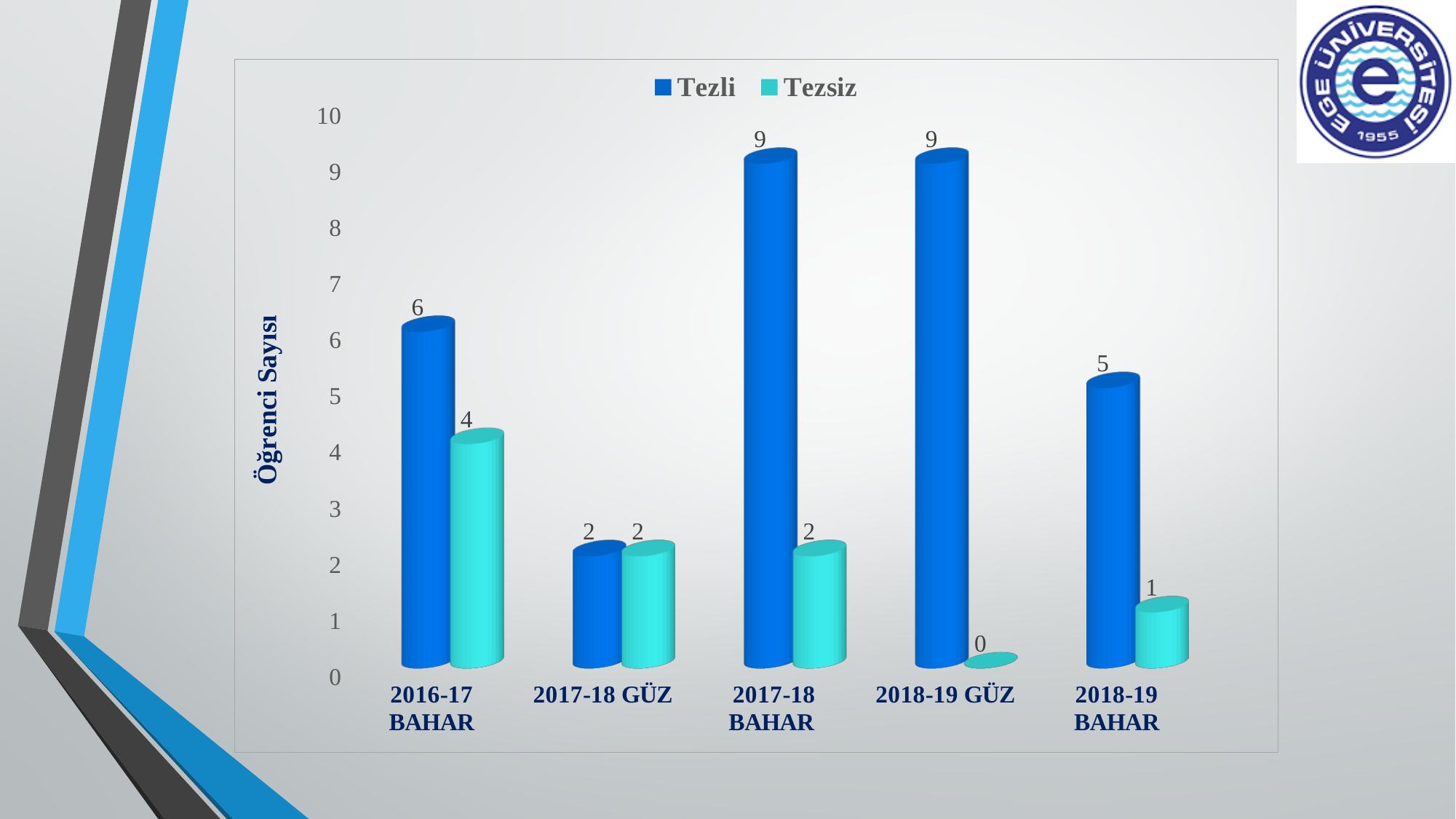
How many categories are shown on the x axis? 5 What is the difference between the Tezli and Tezsiz values for 2017-18 BAHAR? 7 Which is larger for 2016-17 BAHAR, Tezli or Tezsiz? Tezli What is the Tezsiz value for 2018-19 BAHAR? 1 What is the Tezli value for 2016-17 BAHAR? 6 Which category has the highest Tezsiz value? 2016-17 BAHAR Which category has the lowest Tezsiz value? 2018-19 GÜZ How many series does the legend list? 2 What kind of chart is shown on the slide? Bar chart What is the label of the vertical axis? Öğrenci Sayısı What is the Tezli value for 2017-18 GÜZ? 2 What is the Tezsiz value for 2018-19 GÜZ? 0